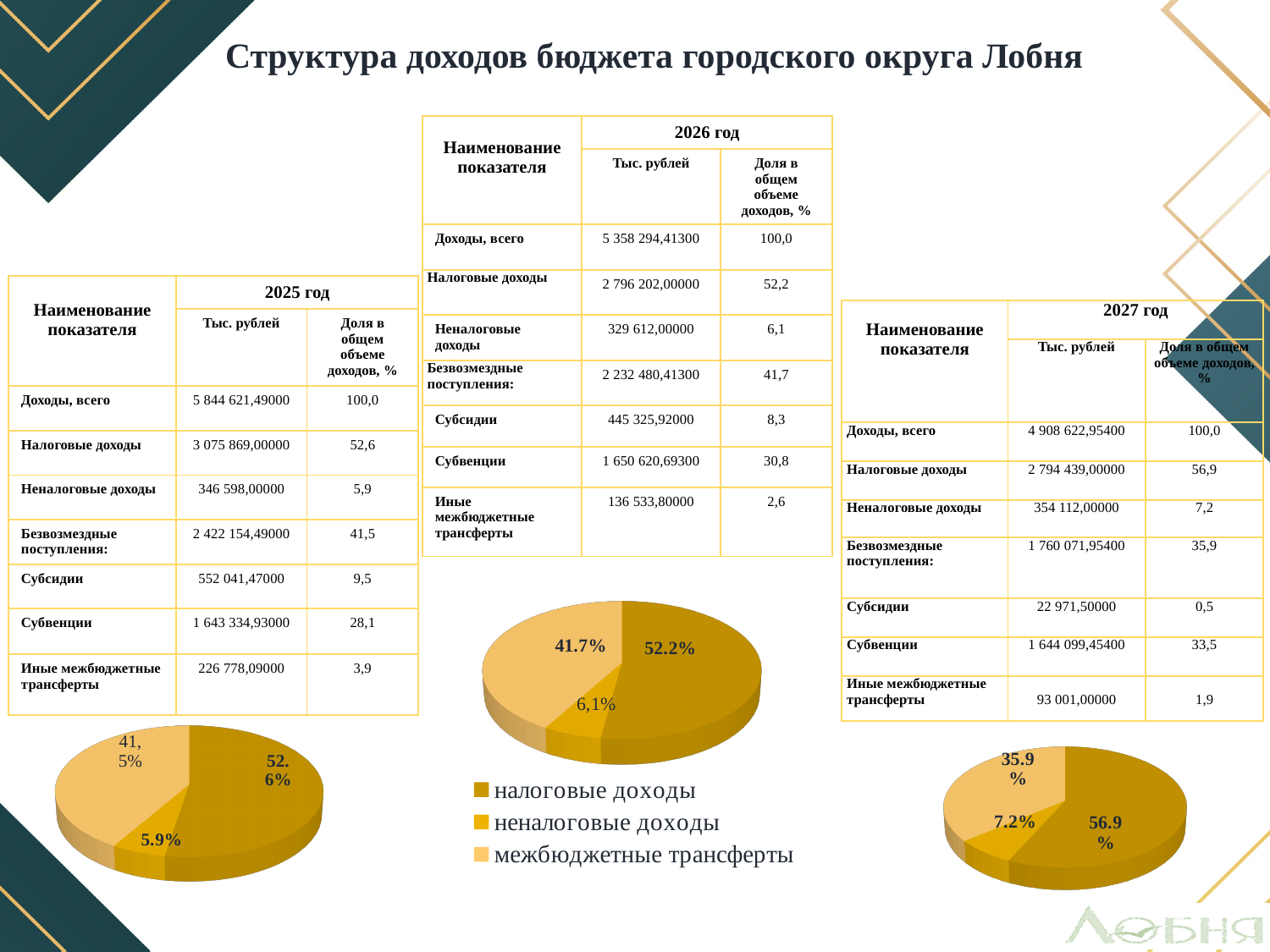
How many entries does the legend below the middle pie chart list? 3 In the middle pie chart, what share is shown for неналоговые доходы? 6,1% How many slices does each pie chart on the slide have? 3 In the bottom-right pie chart, what share is shown for межбюджетные трансферты? 35.9% What kind of chart is shown at the bottom left of the slide? pie chart In the middle pie chart, which category has the largest slice? налоговые доходы In the bottom-right pie chart, what is the difference between the shares of налоговые доходы and межбюджетные трансферты? 21 percentage points In the bottom-left pie chart, what share is shown for неналоговые доходы? 5.9% In the bottom-right pie chart, what share is shown for налоговые доходы? 56.9% In the bottom-right pie chart, which category has the smallest slice? неналоговые доходы In the bottom-left pie chart, what share is shown for налоговые доходы? 52.6% In the middle pie chart, what share is shown for межбюджетные трансферты? 41.7%